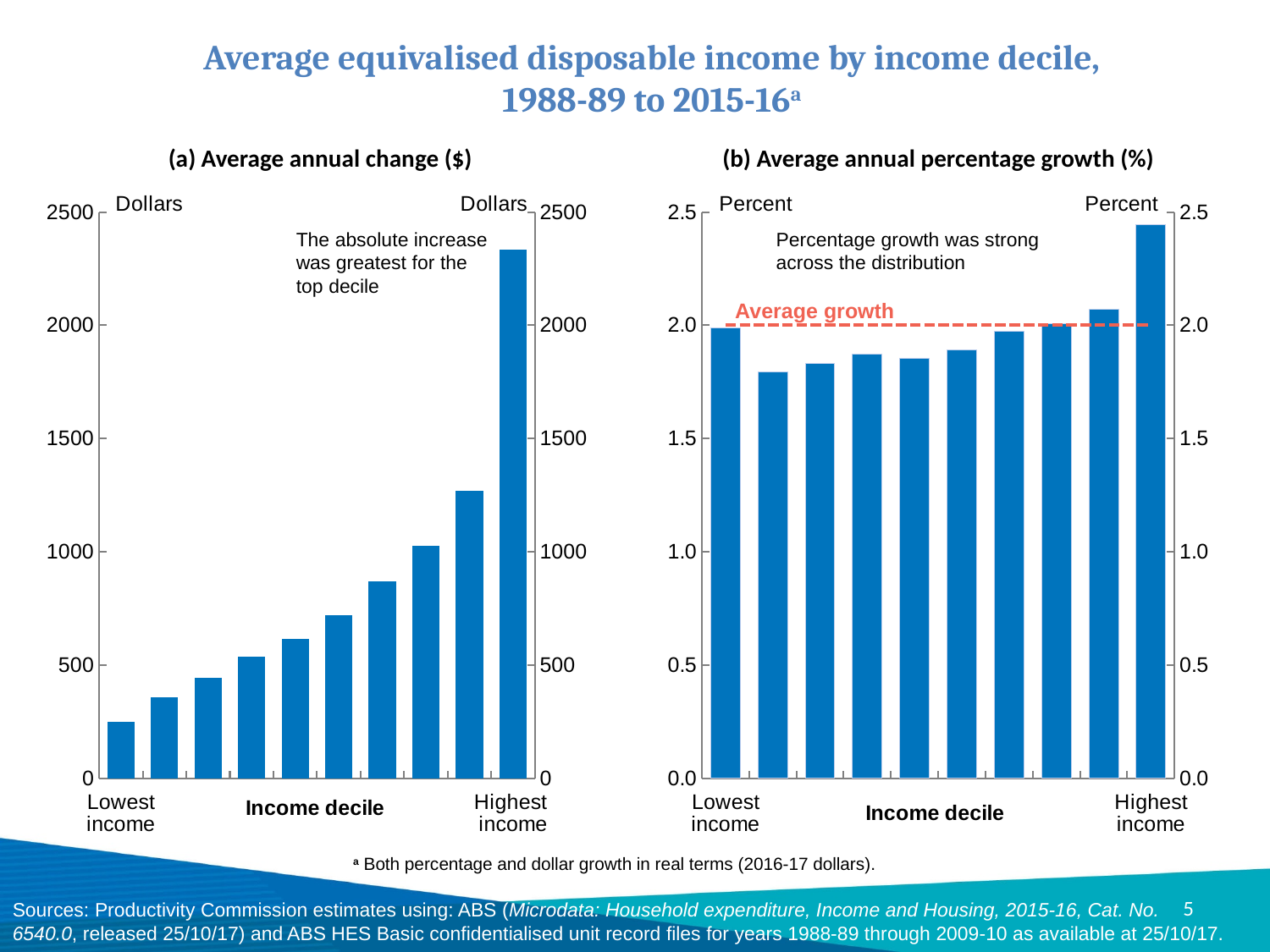
What kind of chart is chart (a), Average annual change ($)? Bar chart In chart (b), Average annual percentage growth (%), is the value for the highest income decile greater or less than 2.0? greater In chart (b), Average annual percentage growth (%), what does the red dashed horizontal line represent? Average growth In chart (a), Average annual change ($), is the value for the highest income decile greater or less than 2000? greater In chart (a), Average annual change ($), is the value for the lowest income decile greater or less than 500? less How many income deciles (bars) are plotted in chart (b), Average annual percentage growth (%)? 10 In chart (a), Average annual change ($), which income decile has the highest average annual change? Highest income How many income deciles (bars) are plotted in chart (a), Average annual change ($)? 10 In chart (b), Average annual percentage growth (%), which is larger: the value for the lowest income decile or the highest income decile? Highest income In chart (a), Average annual change ($), which income decile has the lowest average annual change? Lowest income In chart (a), Average annual change ($), do the values rise or fall moving from the lowest income decile to the highest income decile? Rise In chart (b), Average annual percentage growth (%), which income decile has the highest average annual percentage growth? Highest income